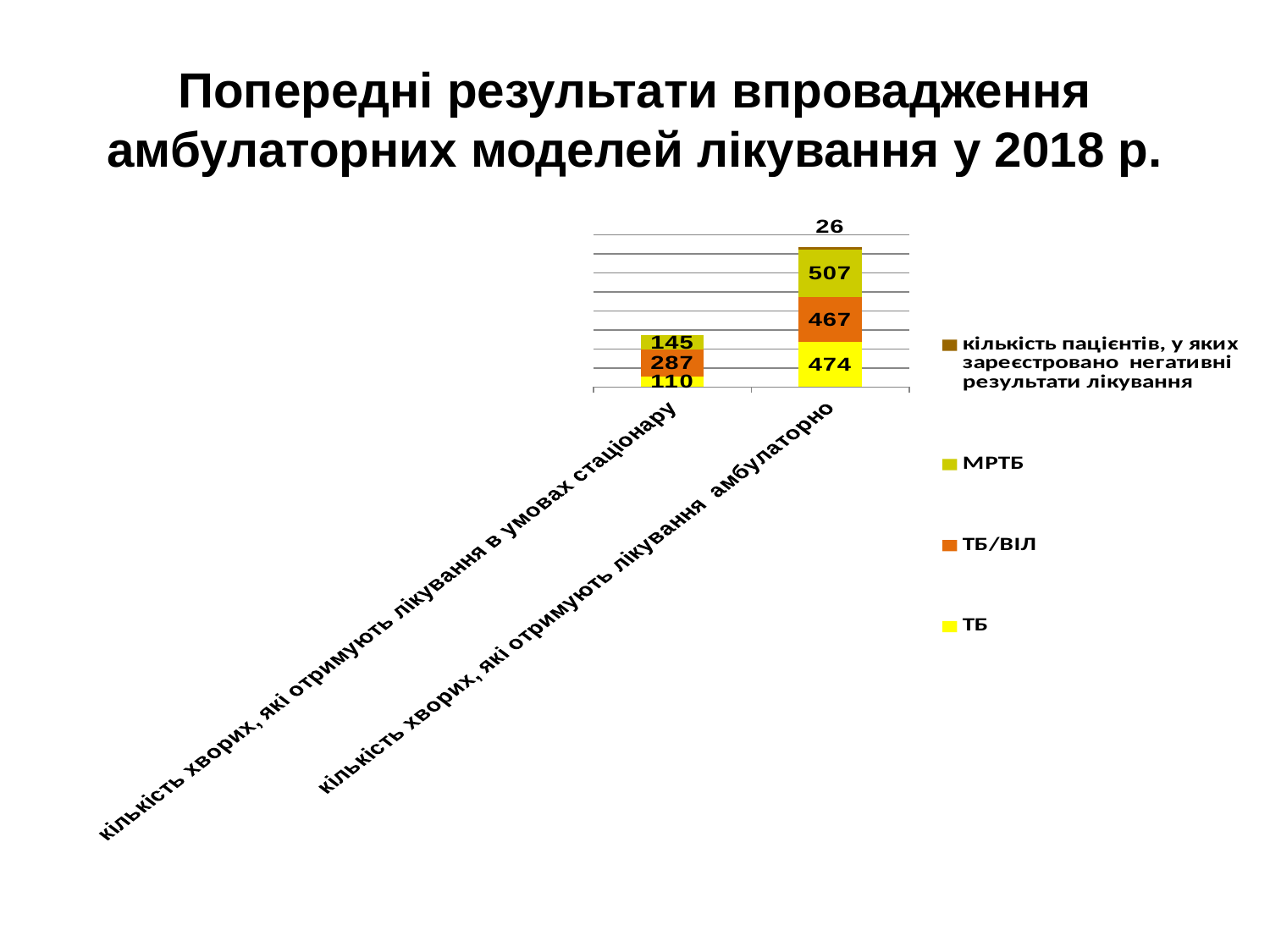
How many series does the legend list? 4 How many outpatients (амбулаторно) had negative treatment results registered? 26 What is the МРТБ value for patients treated as outpatients (амбулаторно)? 507 What type of chart is shown on the slide? stacked bar chart What is the difference between the ТБ/ВІЛ values for outpatient and inpatient treatment? 180 Which series is shown in yellow in the legend? ТБ How many categories are plotted on the x axis? 2 What is the ТБ value for patients treated in hospital (в умовах стаціонару)? 110 What is the ТБ/ВІЛ value for patients treated in hospital (в умовах стаціонару)? 287 What is the ТБ value for patients treated as outpatients (амбулаторно)? 474 Which category has the larger МРТБ value, inpatient (в умовах стаціонару) or outpatient (амбулаторно)? амбулаторно What is the МРТБ value for patients treated in hospital (в умовах стаціонару)? 145